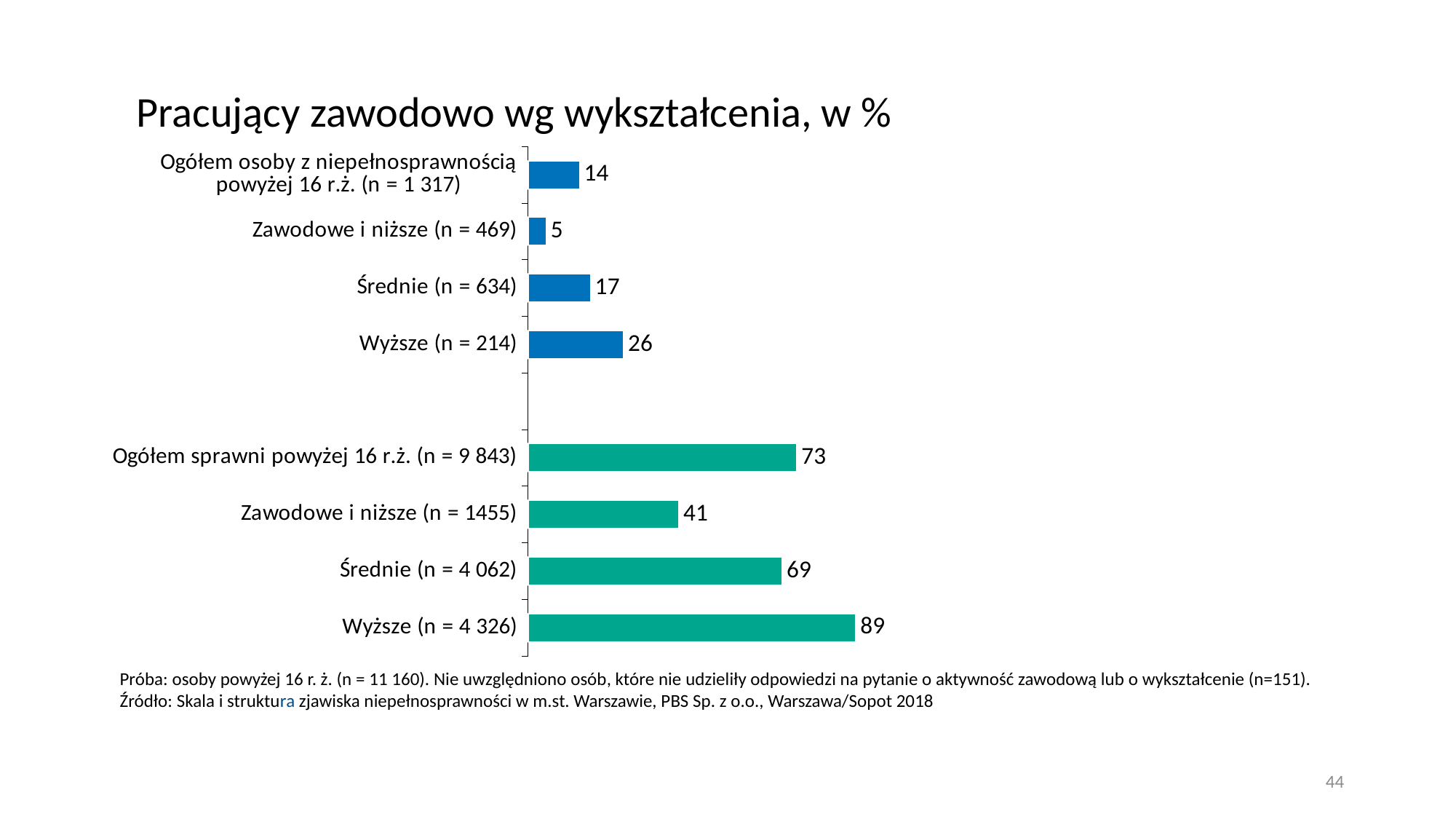
What kind of chart is shown on the slide? Bar chart What is the difference between Ogółem sprawni powyżej 16 r.ż. (n = 9 843) and Ogółem osoby z niepełnosprawnością powyżej 16 r.ż. (n = 1 317)? 59 What is the value for Ogółem osoby z niepełnosprawnością powyżej 16 r.ż. (n = 1 317)? 14 How many bars are plotted on the chart? 8 Which category has the highest value on the chart? Wyższe (n = 4 326) What is the value for Zawodowe i niższe (n = 1455) among able-bodied people? 41 What is the difference between Wyższe (n = 4 326) and Wyższe (n = 214)? 63 What is the value for Wyższe (n = 214) among people with disabilities? 26 What is the title of the chart? Pracujący zawodowo wg wykształcenia, w % What is the value for Średnie (n = 4 062)? 69 Which is larger: the value for Średnie (n = 634) or the value for Zawodowe i niższe (n = 469)? Średnie (n = 634) Which category has the lowest value on the chart? Zawodowe i niższe (n = 469)